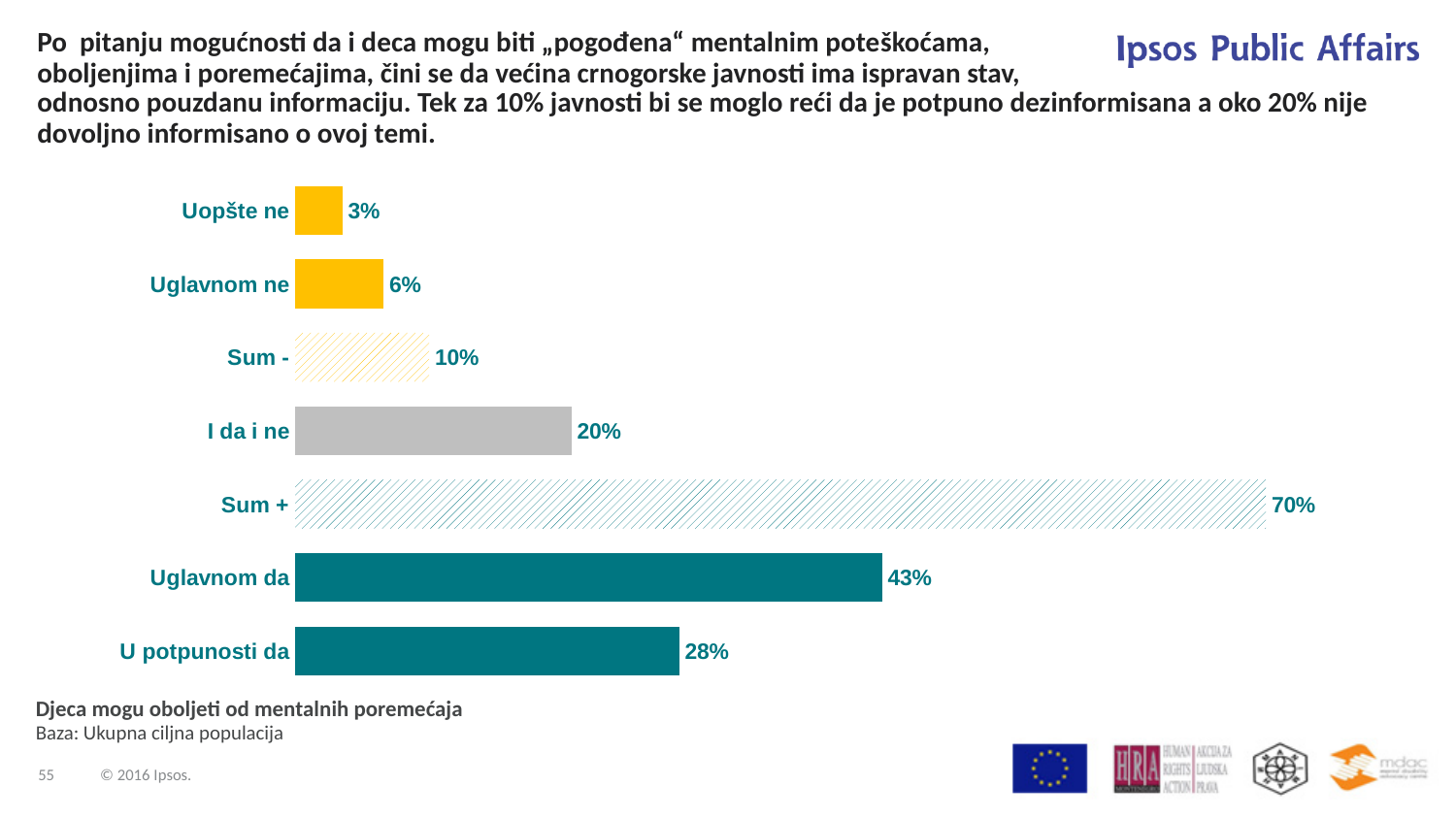
Which category has the highest value? Sum + What is the value for "I da i ne"? 20% What is the value for "Uglavnom da"? 43% What is the value for "Uopšte ne"? 3% How many categories are shown in the chart? 7 Which category has the lowest value? Uopšte ne What is the value for "U potpunosti da"? 28% What is the difference between "Sum +" and "Sum -"? 60% What is the value for "Sum +"? 70% Which is larger, "Uglavnom ne" or "I da i ne"? I da i ne What is the difference between "Uglavnom da" and "U potpunosti da"? 15% What kind of chart is shown on the slide? Bar chart